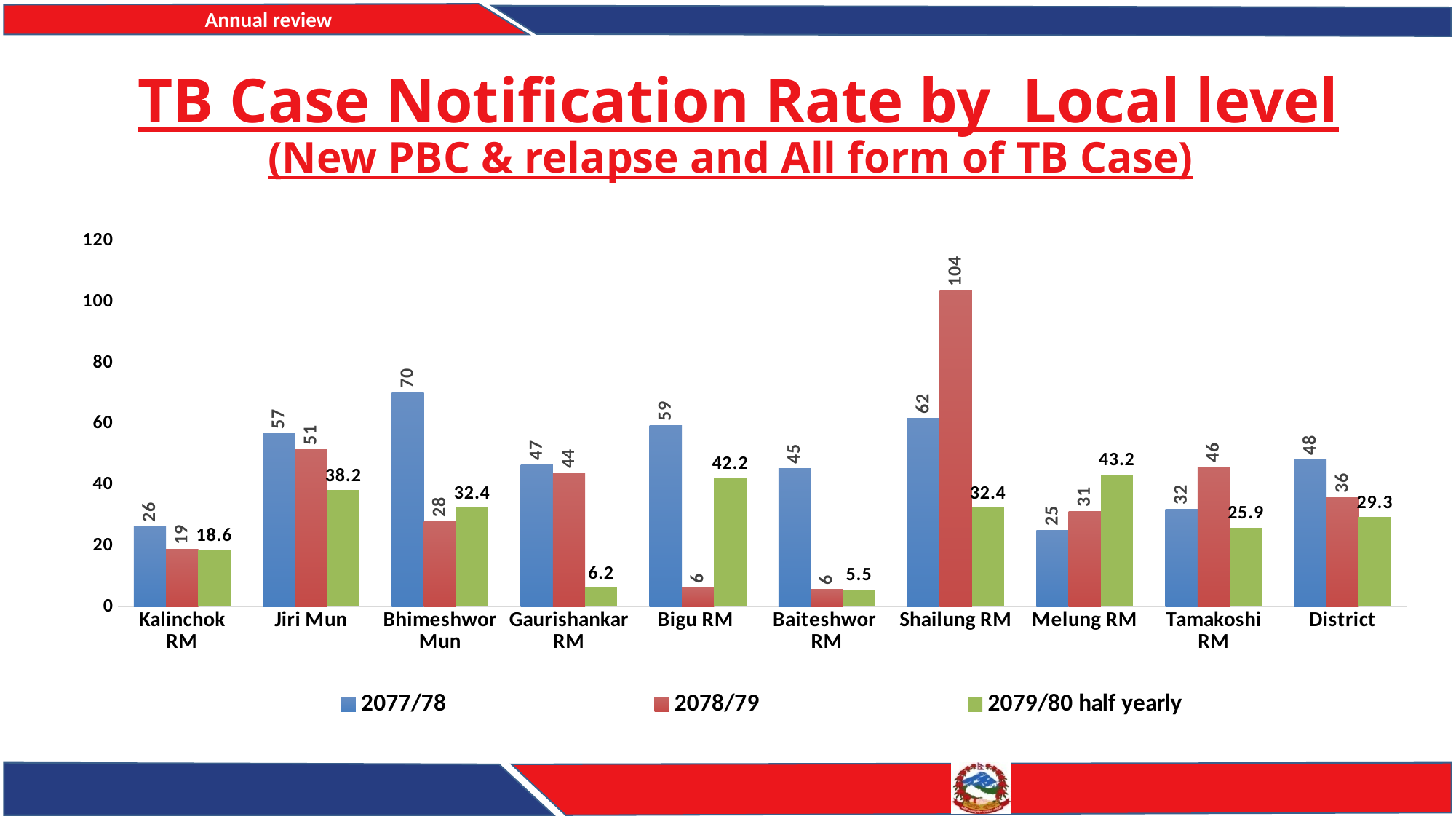
How many series does the legend list? 3 What is the difference between the 2077/78 and 2078/79 values for Bigu RM? 53 Which series is shown in green in the legend? 2079/80 half yearly What kind of chart is shown on the slide? Bar chart Which local level has the highest value in the 2077/78 series? Bhimeshwor Mun Is the 2078/79 value for Shailung RM greater or less than 100? greater What is the value for Bhimeshwor Mun in the 2077/78 series? 70 What is the value for Melung RM in the 2079/80 half yearly series? 43.2 How many local level categories are shown on the x axis? 10 Which local level has the lowest value in the 2079/80 half yearly series? Baiteshwor RM What is the value for Shailung RM in the 2078/79 series? 104 Which is larger for Tamakoshi RM: the 2077/78 value or the 2078/79 value? 2078/79